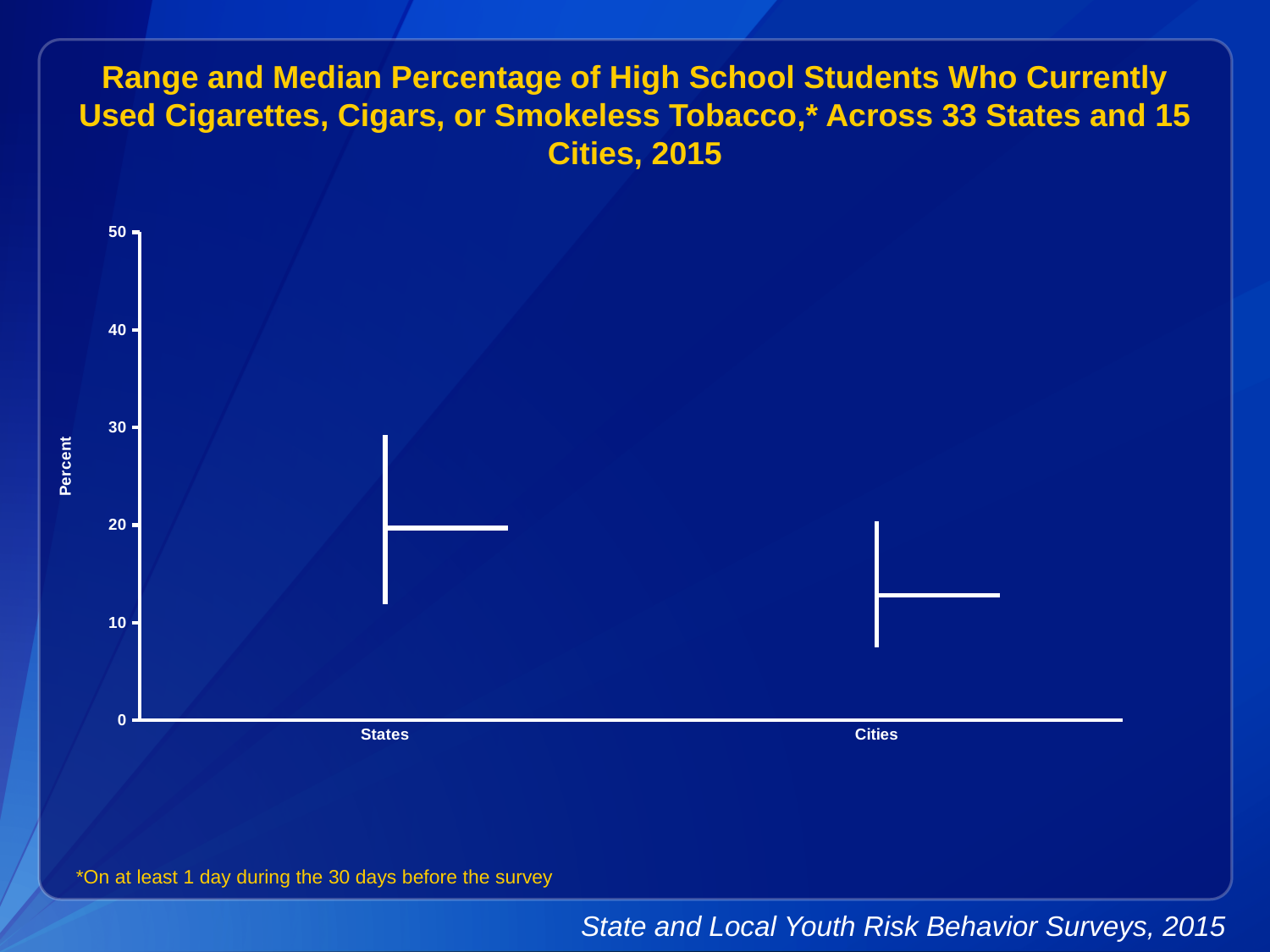
What is the maximum value shown on the y axis of the chart? 50 What is the label on the y axis of the chart? Percent Is the highest value in the range for States greater or less than 20? greater Is the median value for Cities greater or less than 10? greater Which category has the higher median percentage, States or Cities? States Is the lowest value in the range for Cities greater or less than 10? less Which category has the lower bottom of its range, States or Cities? Cities Which category has the higher top of its range, States or Cities? States How many categories are shown on the x axis of the chart? 2